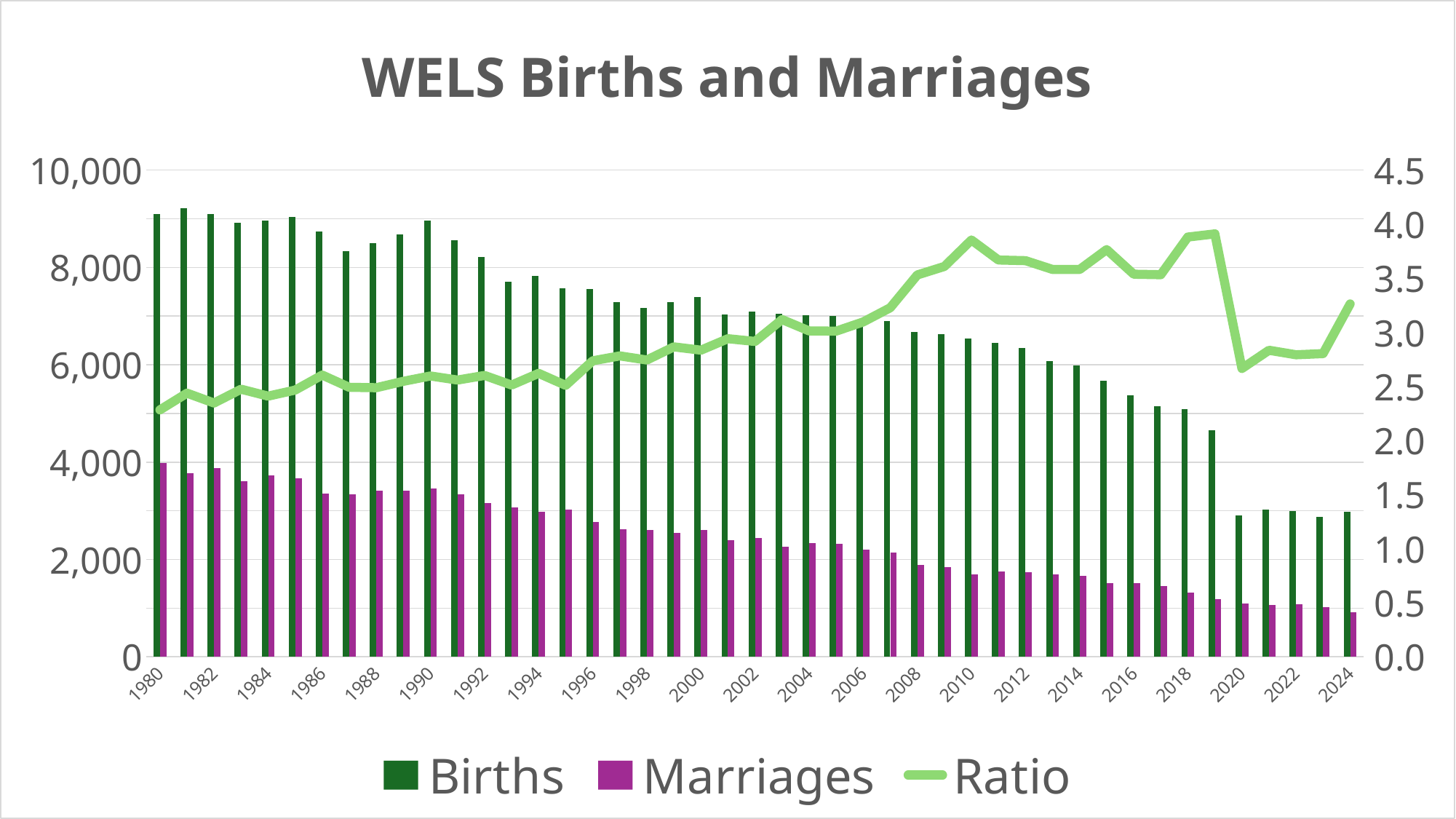
Which year has the lowest Marriages value? 2024 How many series does the legend list? 3 Do the Marriages values generally rise or fall from 1980 to 2024? Fall Is the Births value for 1980 greater or less than 8,000? greater Do the Births values generally rise or fall from 1980 to 2024? Fall Which year has the highest Marriages value? 1980 What is the title of the chart? WELS Births and Marriages How many years are plotted along the x axis? 45 Is the Ratio value for 2020 greater or less than 3.0? less Which series is plotted as a line rather than bars? Ratio Which year has the lowest Ratio value? 1980 What kind of chart is shown on the slide? A combination bar and line chart